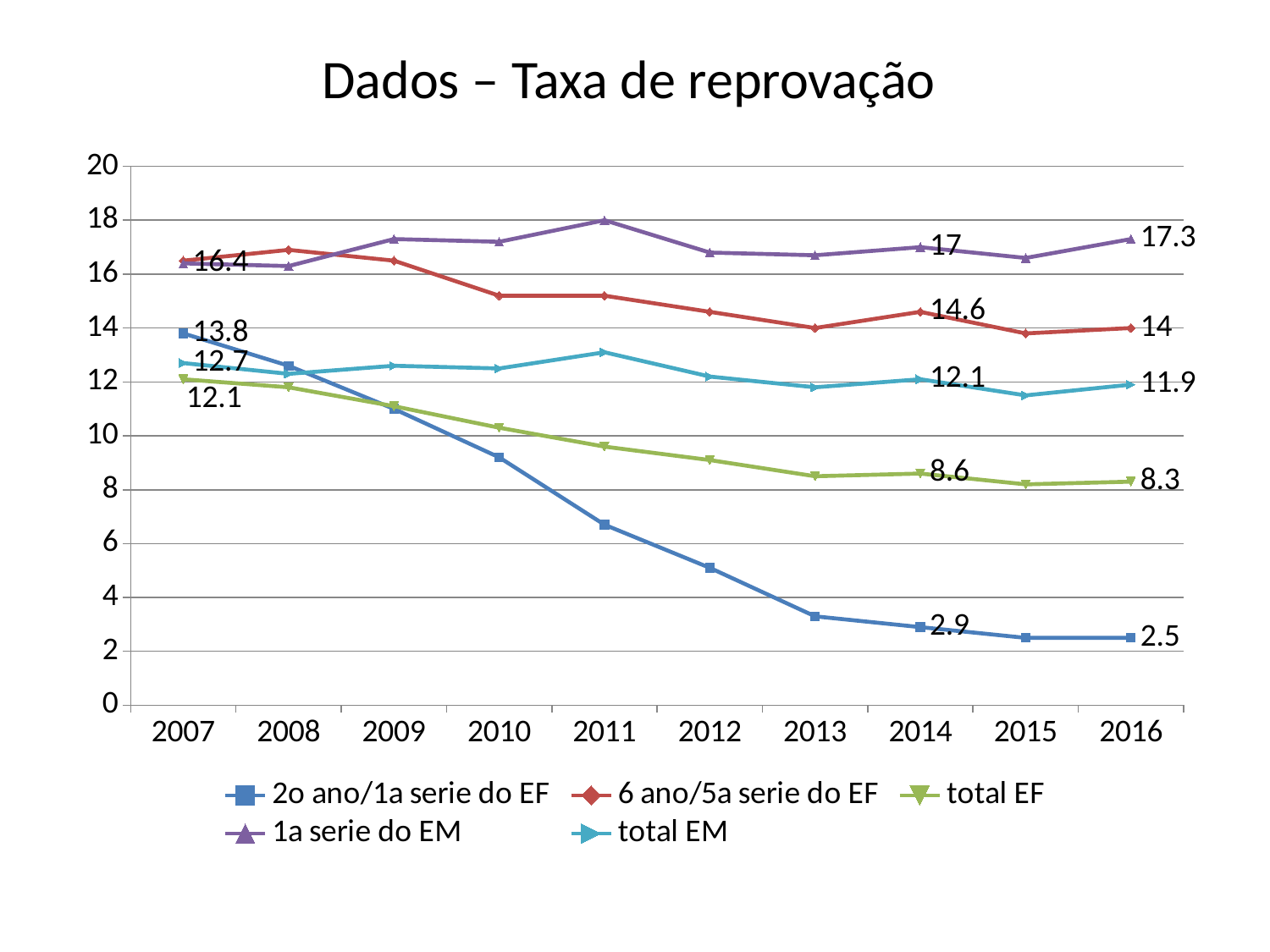
What is the difference between the 2014 and 2016 values for "6 ano/5a serie do EF"? 0.6 What is the value for "total EM" in 2016? 11.9 In 2014, which is larger: the value for "total EM" or the value for "total EF"? total EM Which series has the highest value in 2016? 1a serie do EM Does the value for "2o ano/1a serie do EF" rise or fall from 2007 to 2016? fall How many series does the legend list? 5 Is the value for "2o ano/1a serie do EF" in 2011 greater or less than 8? less What is the value for "1a serie do EM" in 2014? 17 Which series has the lowest value in 2016? 2o ano/1a serie do EF By how much did the value for "2o ano/1a serie do EF" fall from 2007 to 2016? 11.3 What is the value for "total EF" in 2007? 12.1 What is the value for "2o ano/1a serie do EF" in 2016? 2.5